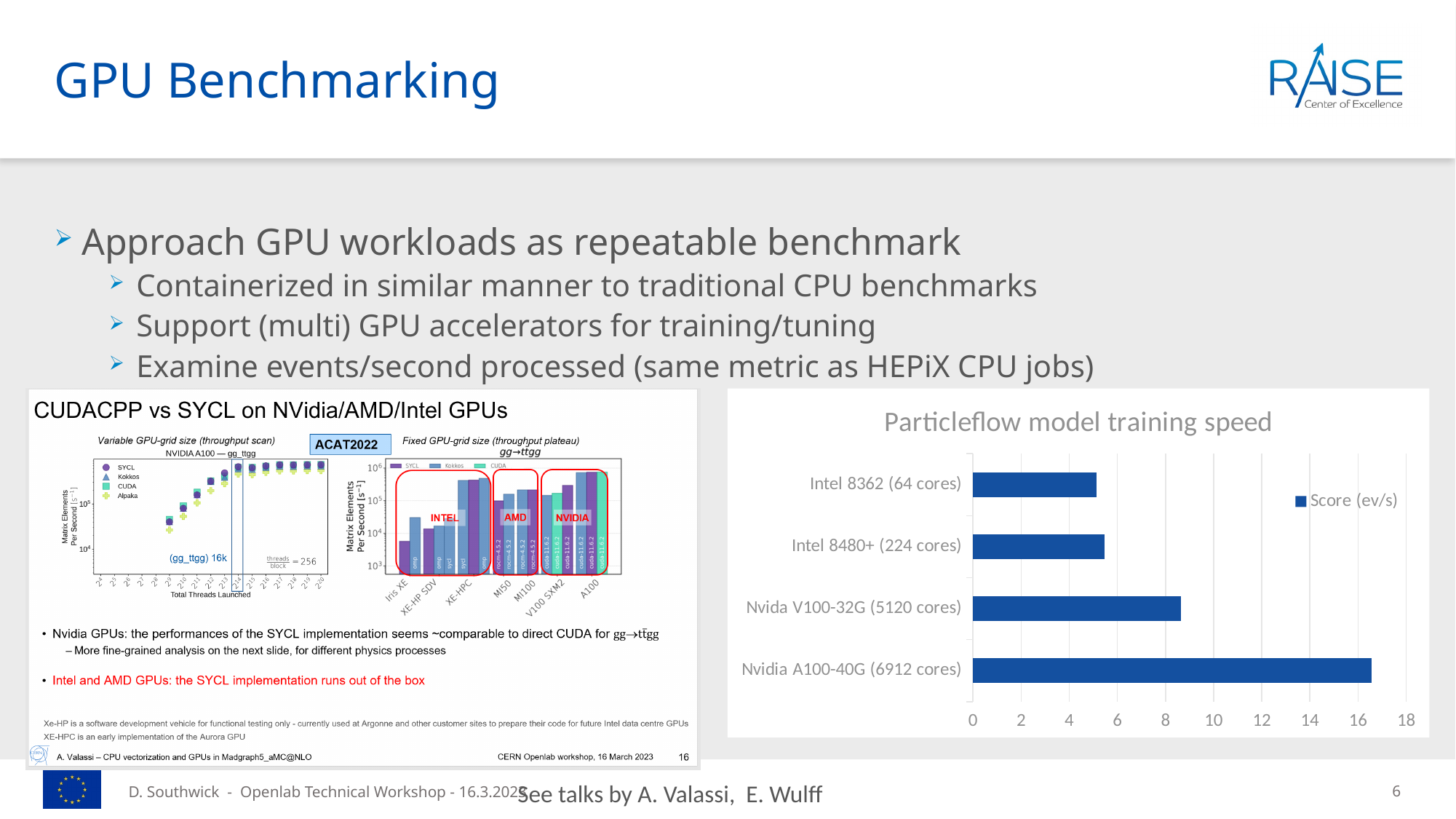
In the 'Particleflow model training speed' chart, what is the maximum value shown on the horizontal axis? 18 In the 'Particleflow model training speed' chart, is the value for Nvidia A100-40G (6912 cores) greater or less than 14? greater In the 'Particleflow model training speed' chart, is the value for Nvidia V100-32G (5120 cores) greater or less than 10? less In the 'Particleflow model training speed' chart, how many GPU/CPU categories are plotted? 4 In the 'Particleflow model training speed' chart, which category has the highest score? Nvidia A100-40G (6912 cores) In the 'Particleflow model training speed' chart, is the value for Intel 8480+ (224 cores) greater or less than 8? less In the 'Particleflow model training speed' chart, what is the legend entry for the plotted series? Score (ev/s) In the embedded 'CUDACPP vs SYCL on NVidia/AMD/Intel GPUs' slide, how many series does the legend of the left-hand 'Variable GPU-grid size' chart list? 4 In the 'Particleflow model training speed' chart, which has the larger score: Nvidia V100-32G (5120 cores) or Intel 8480+ (224 cores)? Nvidia V100-32G (5120 cores) In the 'Particleflow model training speed' chart, how many series does the legend list? 1 What kind of chart is the 'Particleflow model training speed' chart? bar chart